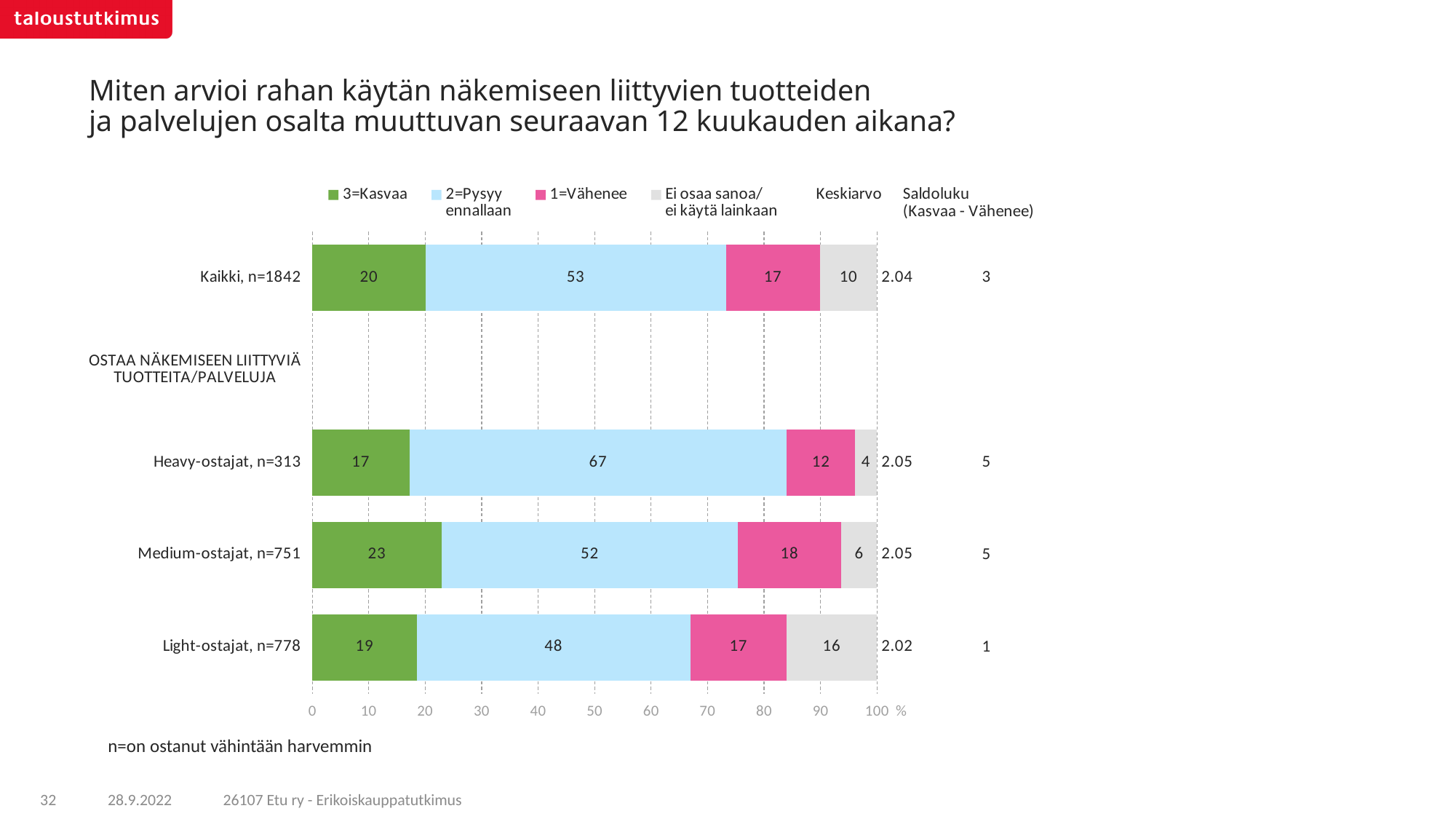
Which group has the lowest value for "Ei osaa sanoa/ei käytä lainkaan"? Heavy-ostajat, n=313 What kind of chart is shown on the slide? Stacked bar chart What is the value of "3=Kasvaa" for Medium-ostajat, n=751? 23 What is the Saldoluku (Kasvaa - Vähenee) for Light-ostajat, n=778? 1 What is the difference between the "1=Vähenee" values for Medium-ostajat, n=751 and Heavy-ostajat, n=313? 6 What is the value of "2=Pysyy ennallaan" for Heavy-ostajat, n=313? 67 What is the Keskiarvo value for Kaikki, n=1842? 2.04 Which group has the highest value for "2=Pysyy ennallaan"? Heavy-ostajat, n=313 Which is larger: the "3=Kasvaa" value for Kaikki, n=1842 or for Light-ostajat, n=778? Kaikki, n=1842 What is the value of "Ei osaa sanoa/ei käytä lainkaan" for Light-ostajat, n=778? 16 How many series does the chart legend list? 4 How many groups (bars) are plotted in the chart? 4